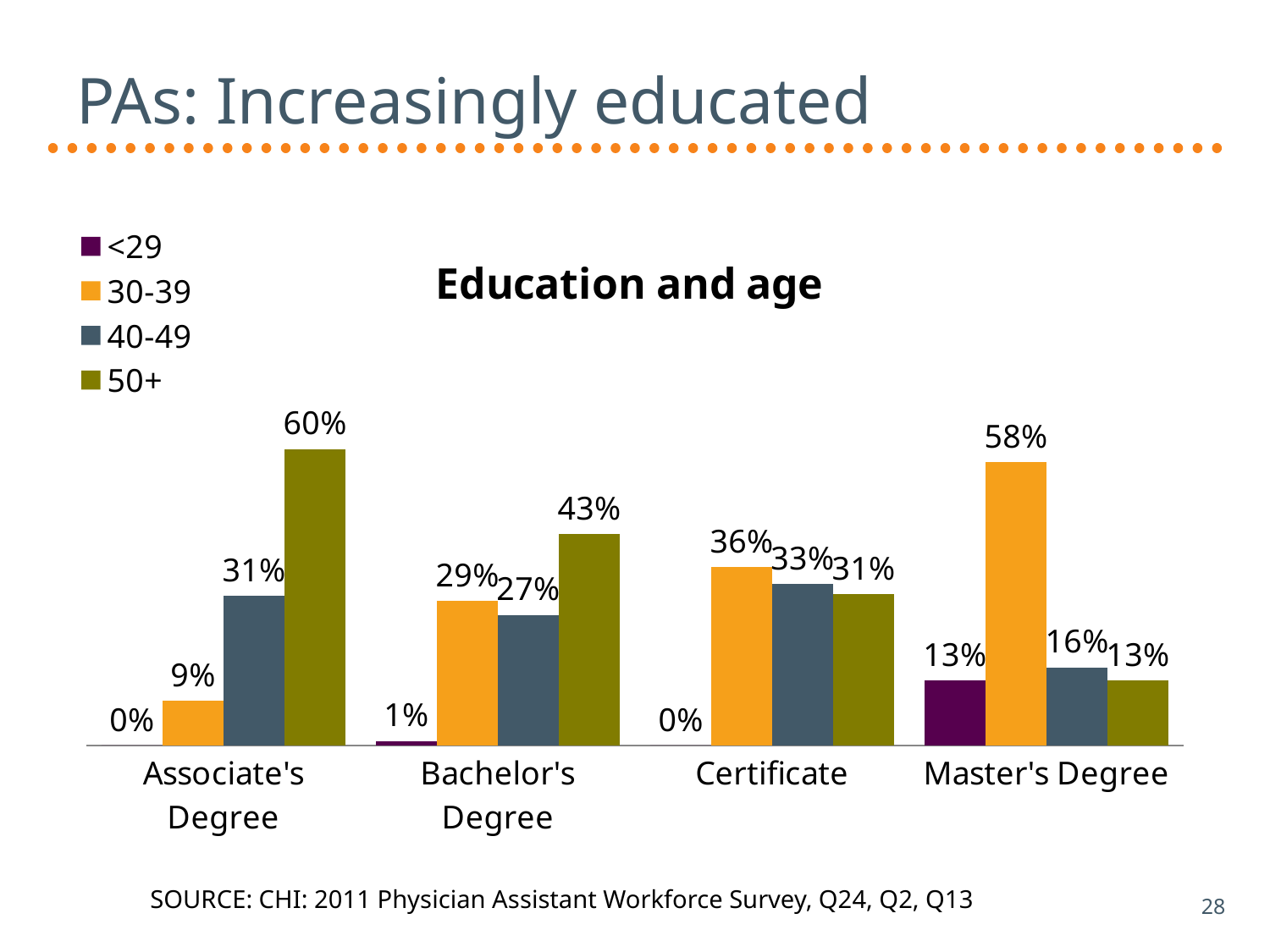
What is the value for the 50+ series for Associate's Degree? 60% What is the value for the 40-49 series for Certificate? 33% What is the value for the <29 series for Bachelor's Degree? 1% Which is larger for Certificate: the 30-39 value or the 50+ value? 30-39 What is the difference between the 50+ value and the 40-49 value for Associate's Degree? 29% Which education category has the lowest value for the 50+ series? Master's Degree What is the title of the chart? Education and age Which education category has the highest value for the 30-39 series? Master's Degree What is the value for the 30-39 series for Master's Degree? 58% How many education categories are shown on the x axis? 4 How many series does the legend list? 4 What kind of chart is shown on the slide? Bar chart